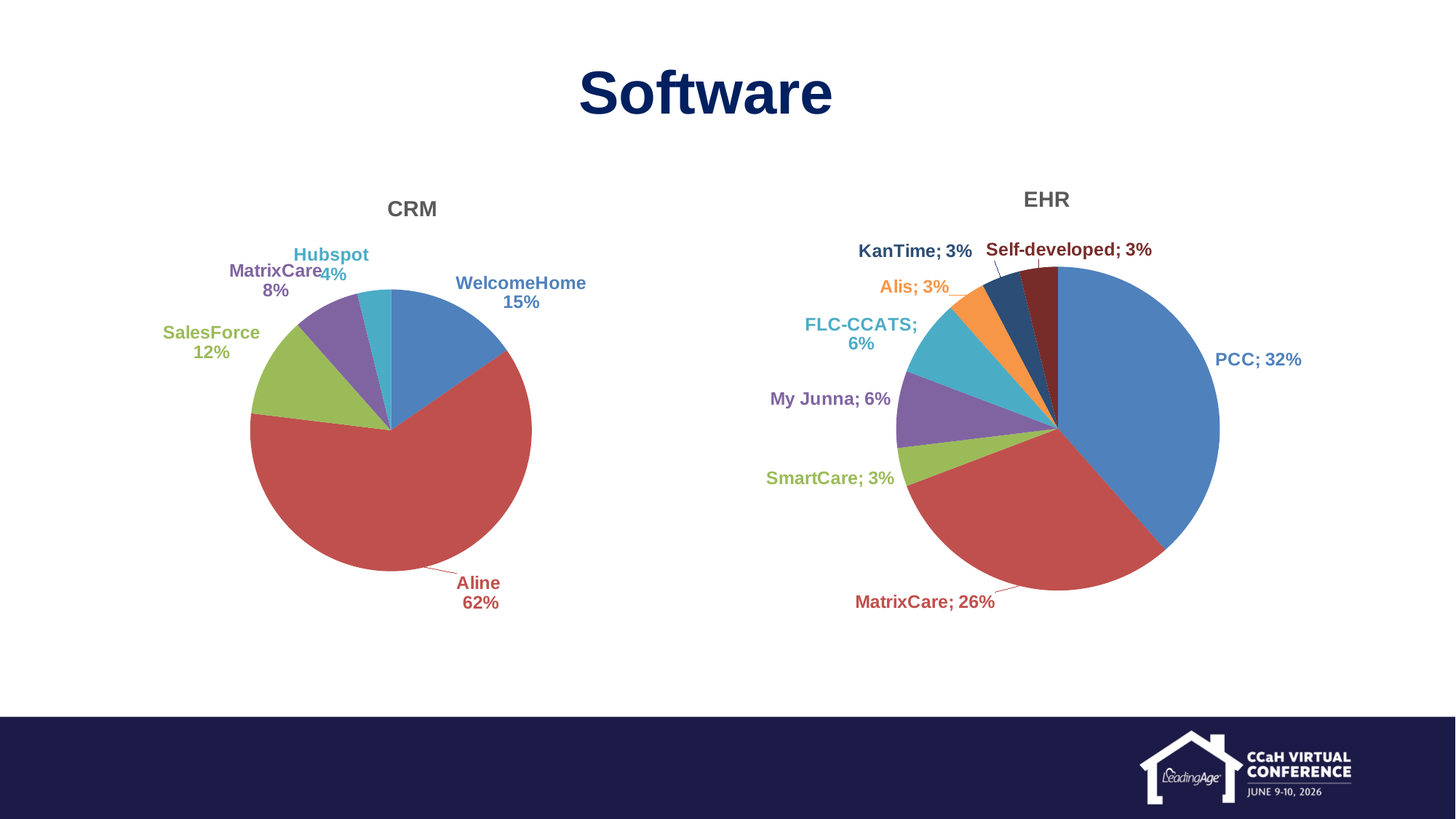
In the CRM chart, which category has the smallest share? Hubspot In the EHR chart, which is larger, MatrixCare or FLC-CCATS? MatrixCare In the EHR chart, how many slices does the pie have? 8 In the EHR chart, which category has the largest share? PCC In the CRM chart, how many slices does the pie have? 5 In the EHR chart, what share does My Junna have? 6% In the CRM chart, what share does Aline have? 62% In the CRM chart, what is the difference between the shares of WelcomeHome and MatrixCare? 7% In the EHR chart, what share does PCC have? 32% In the CRM chart, which category has the largest share? Aline In the CRM chart, what share does SalesForce have? 12% What type of chart is the EHR chart? Pie chart